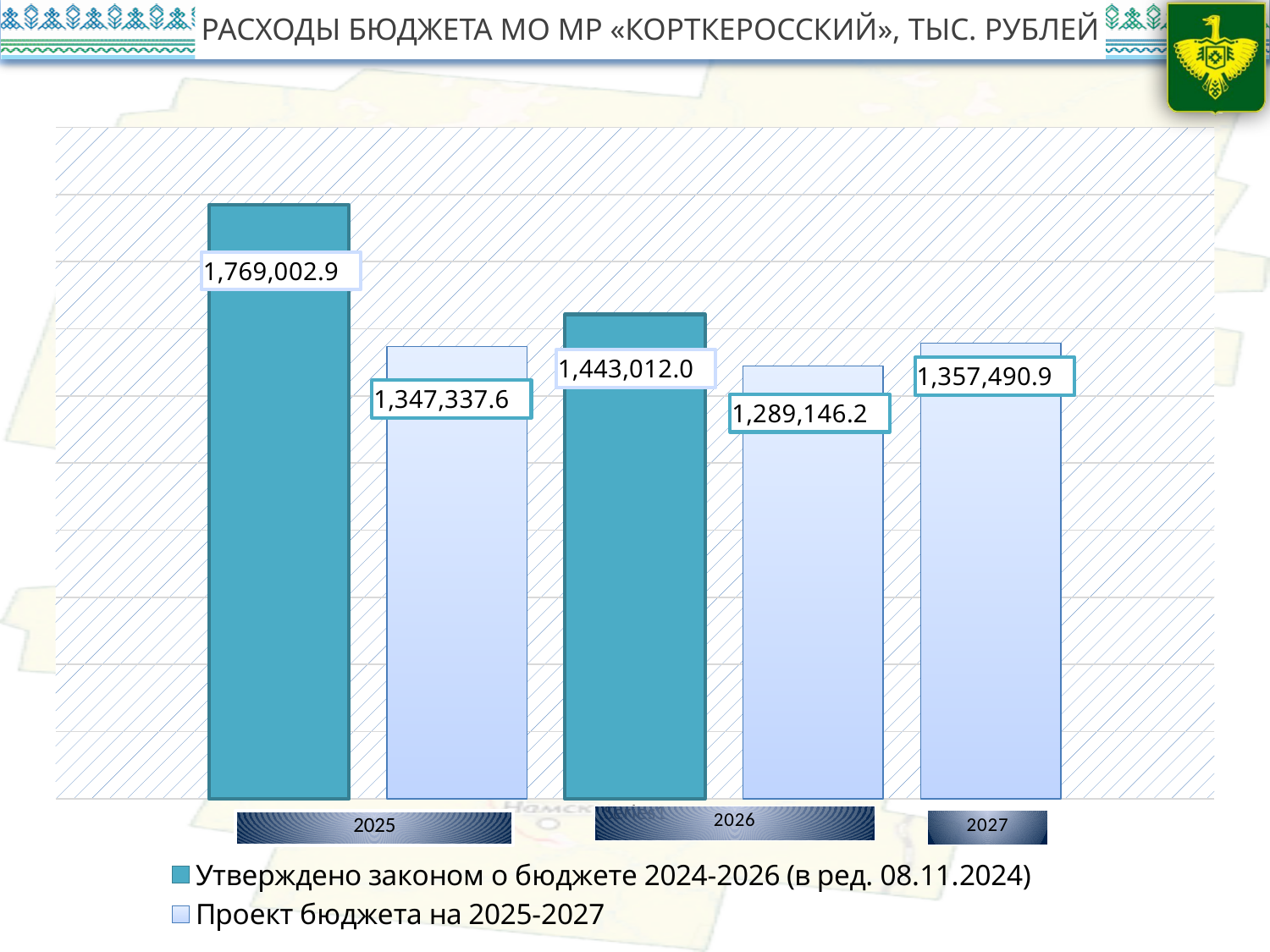
How many series does the legend list? 2 What is the value for 2026 in the series «Утверждено законом о бюджете 2024-2026 (в ред. 08.11.2024)»? 1,443,012.0 Which year has the lowest value in the series «Проект бюджета на 2025-2027»? 2026 What is the value for 2026 in the series «Проект бюджета на 2025-2027»? 1,289,146.2 What type of chart is shown on the slide? bar chart How many years are shown on the x axis? 3 What is the value for 2027 in the series «Проект бюджета на 2025-2027»? 1,357,490.9 Which is larger for 2026: the value in «Утверждено законом о бюджете 2024-2026 (в ред. 08.11.2024)» or in «Проект бюджета на 2025-2027»? Утверждено законом о бюджете 2024-2026 (в ред. 08.11.2024) What is the difference between the two series' values for 2025? 421,665.3 What is the difference between the two series' values for 2026? 153,865.8 Which year has the highest value in the series «Проект бюджета на 2025-2027»? 2027 What is the value for 2025 in the series «Утверждено законом о бюджете 2024-2026 (в ред. 08.11.2024)»? 1,769,002.9